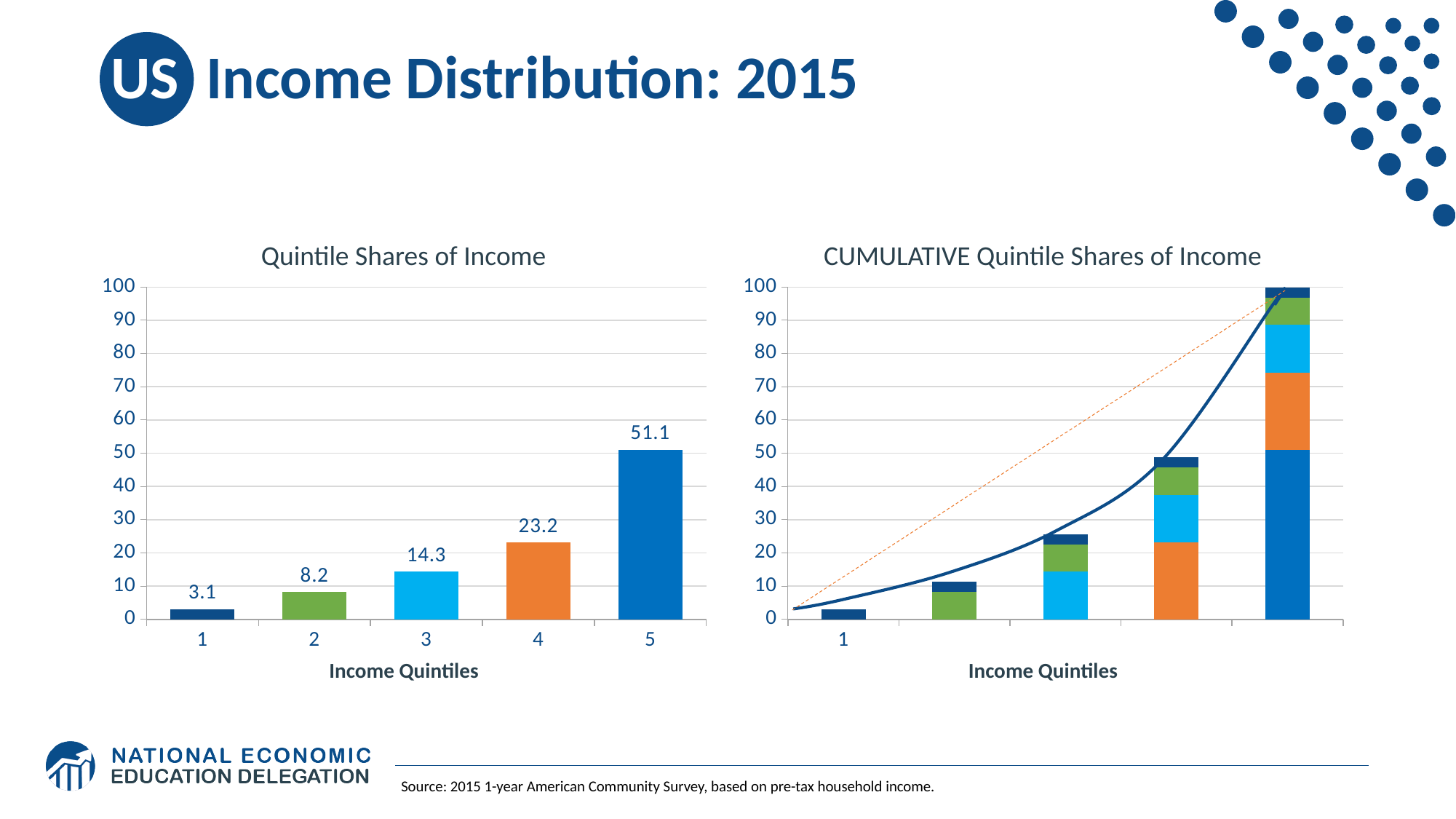
In the Quintile Shares of Income chart, what is the value for income quintile 1? 3.1 In the Quintile Shares of Income chart, which income quintile has the highest share? 5 In the Quintile Shares of Income chart, what is the difference between the values for quintile 5 and quintile 4? 27.9 What kind of chart is the Quintile Shares of Income chart? bar chart How many income quintiles are shown in the Quintile Shares of Income chart? 5 In the Quintile Shares of Income chart, is the value for quintile 4 greater or less than 20? greater In the Quintile Shares of Income chart, what is the value for income quintile 5? 51.1 In the CUMULATIVE Quintile Shares of Income chart, is the value of the bar for quintile 1 greater or less than 10? less In the Quintile Shares of Income chart, what is the value for income quintile 3? 14.3 In the Quintile Shares of Income chart, which is larger, the value for quintile 2 or the value for quintile 3? quintile 3 In the Quintile Shares of Income chart, which income quintile has the lowest share? 1 In the Quintile Shares of Income chart, do the values rise or fall from quintile 1 to quintile 5? rise